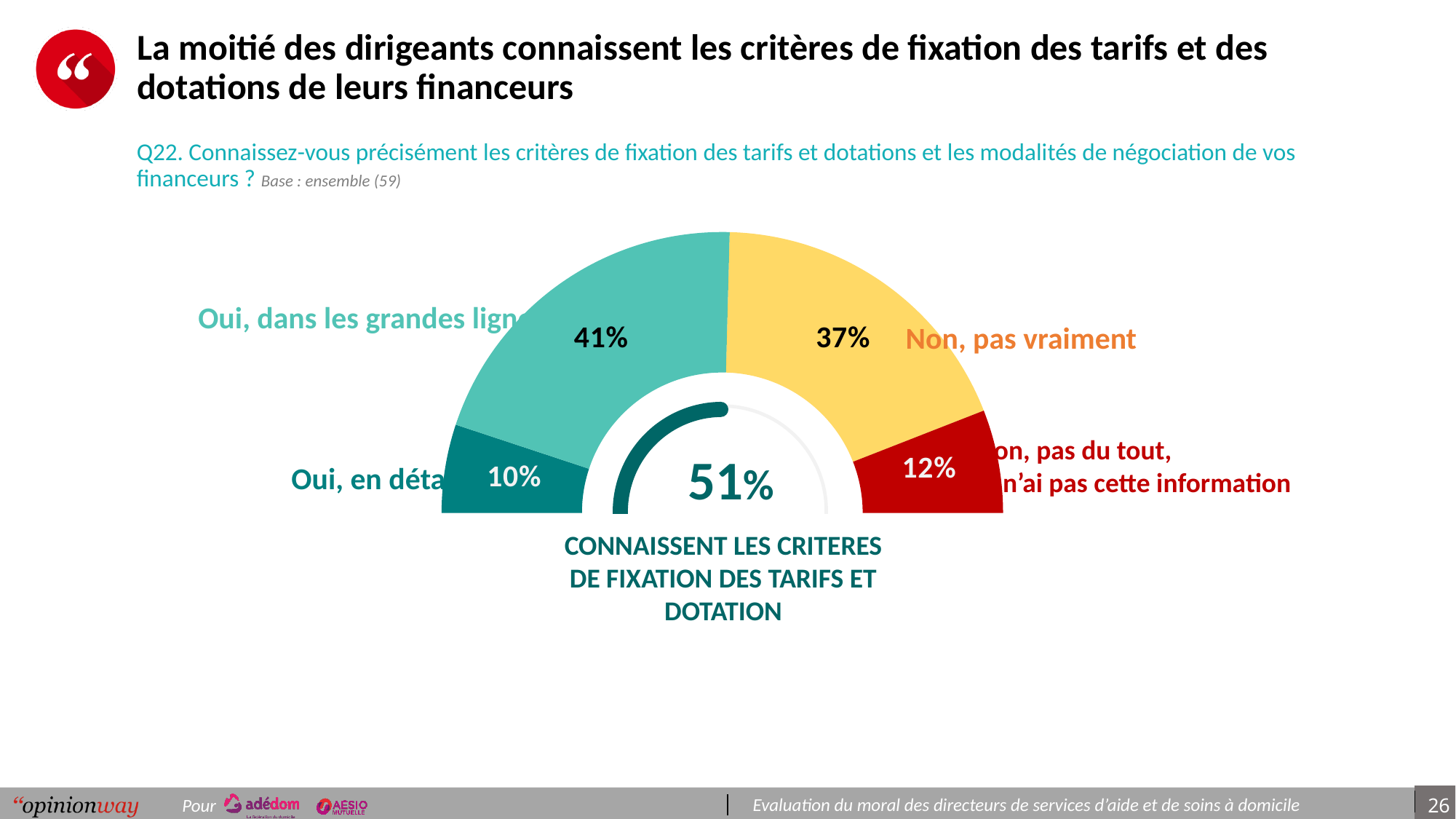
Which is larger: the share for "Non, pas vraiment" or the share for "Non, pas du tout"? Non, pas vraiment Which response category has the largest share? Oui, dans les grandes lignes What percentage of respondents answered "Non, pas du tout, je n'ai pas cette information"? 12% What figure is displayed in the centre of the chart? 51% What percentage of respondents answered "Oui, dans les grandes lignes"? 41% What kind of chart is used on this slide? Pie chart (semi-circular donut) What percentage of respondents answered "Non, pas vraiment"? 37% What is the difference in percentage points between "Oui, dans les grandes lignes" and "Non, pas vraiment"? 4 percentage points What percentage of respondents answered "Oui, en détail"? 10% Which response category has the smallest share? Oui, en détail What is the combined share of the two "Oui" responses ("Oui, en détail" and "Oui, dans les grandes lignes")? 51% How many response categories are shown in the chart? 4